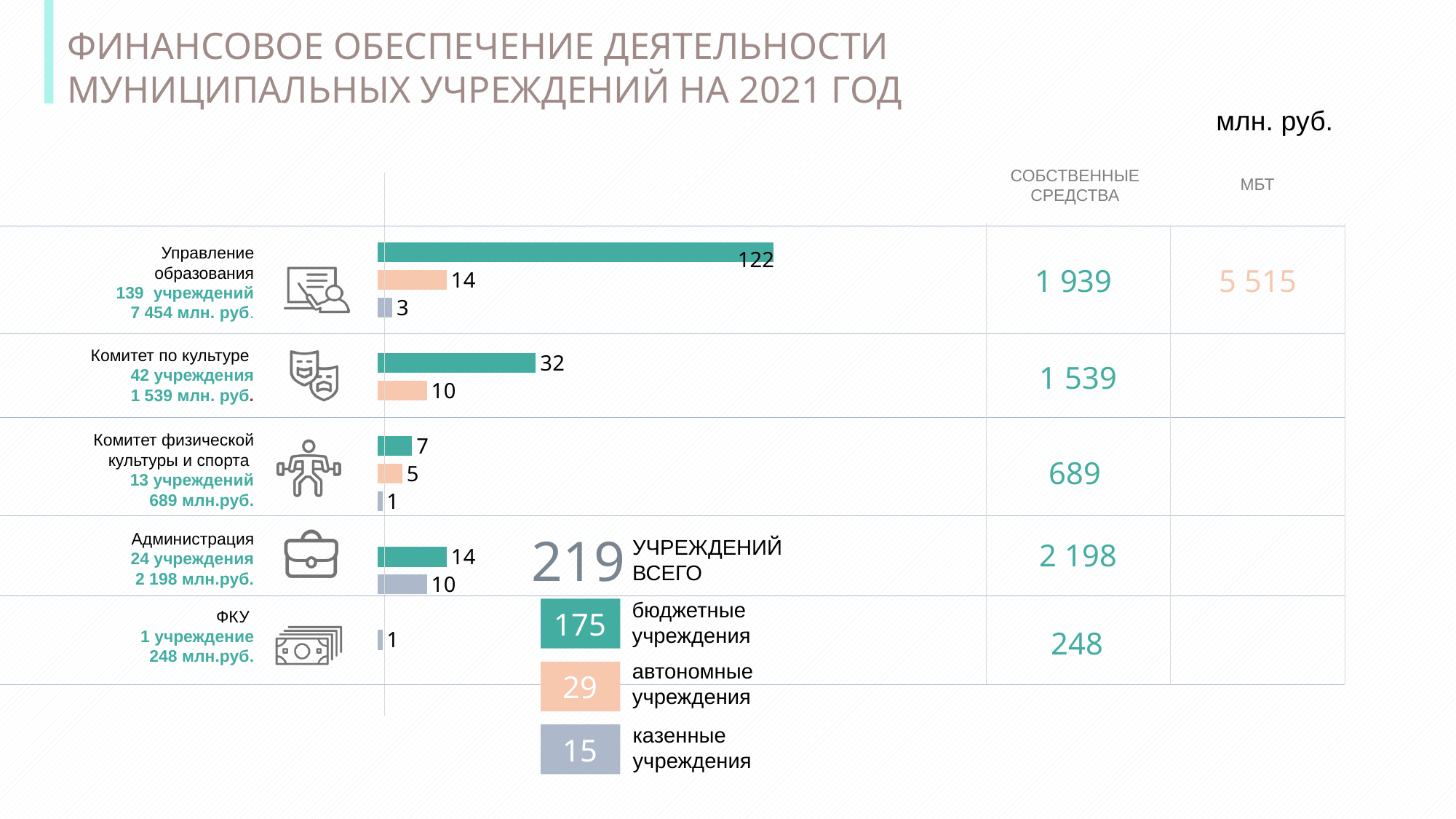
How many казенные учреждения does Администрация have according to the chart? 10 What is the total number of учреждений shown in the legend for бюджетные учреждения? 175 Which is larger: the number of бюджетные учреждения of Администрация or of Комитет физической культуры и спорта? Администрация How many бюджетные учреждения does Управление образования have according to the chart? 122 What colour represents автономные учреждения in the chart? peach (light orange) What type of chart is shown on the slide? bar chart Which category has the highest number of бюджетные учреждения? Управление образования How many series does the legend list? 3 How many categories (departments) are shown in the bar chart? 5 How many бюджетные учреждения does Комитет физической культуры и спорта have? 7 How many автономные учреждения does Комитет по культуре have according to the chart? 10 What is the difference between the number of бюджетные учреждения of Управление образования and Комитет по культуре? 90